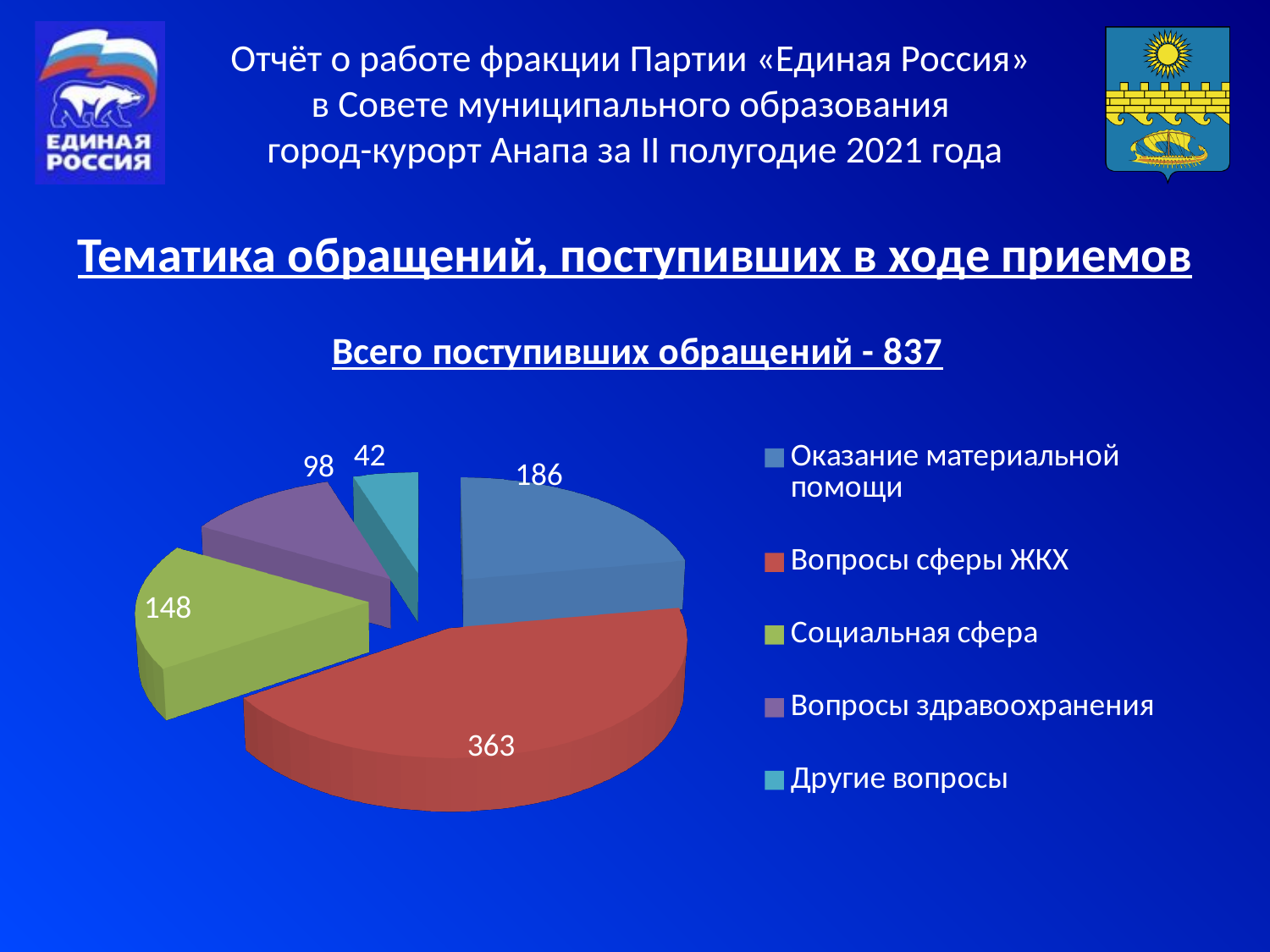
What is the value for Вопросы сферы ЖКХ? 363 What is the value for Вопросы здравоохранения? 98 What total number of appeals is stated above the chart? 837 Which category has the largest slice of the pie? Вопросы сферы ЖКХ What kind of chart is shown on the slide? Pie chart How many slices does the pie chart have? 5 What is the difference between the values for Вопросы сферы ЖКХ and Оказание материальной помощи? 177 Which is larger, the value for Социальная сфера or the value for Вопросы здравоохранения? Социальная сфера What is the value for Другие вопросы? 42 What is the value for Социальная сфера? 148 What is the value for Оказание материальной помощи? 186 Which category has the smallest slice of the pie? Другие вопросы